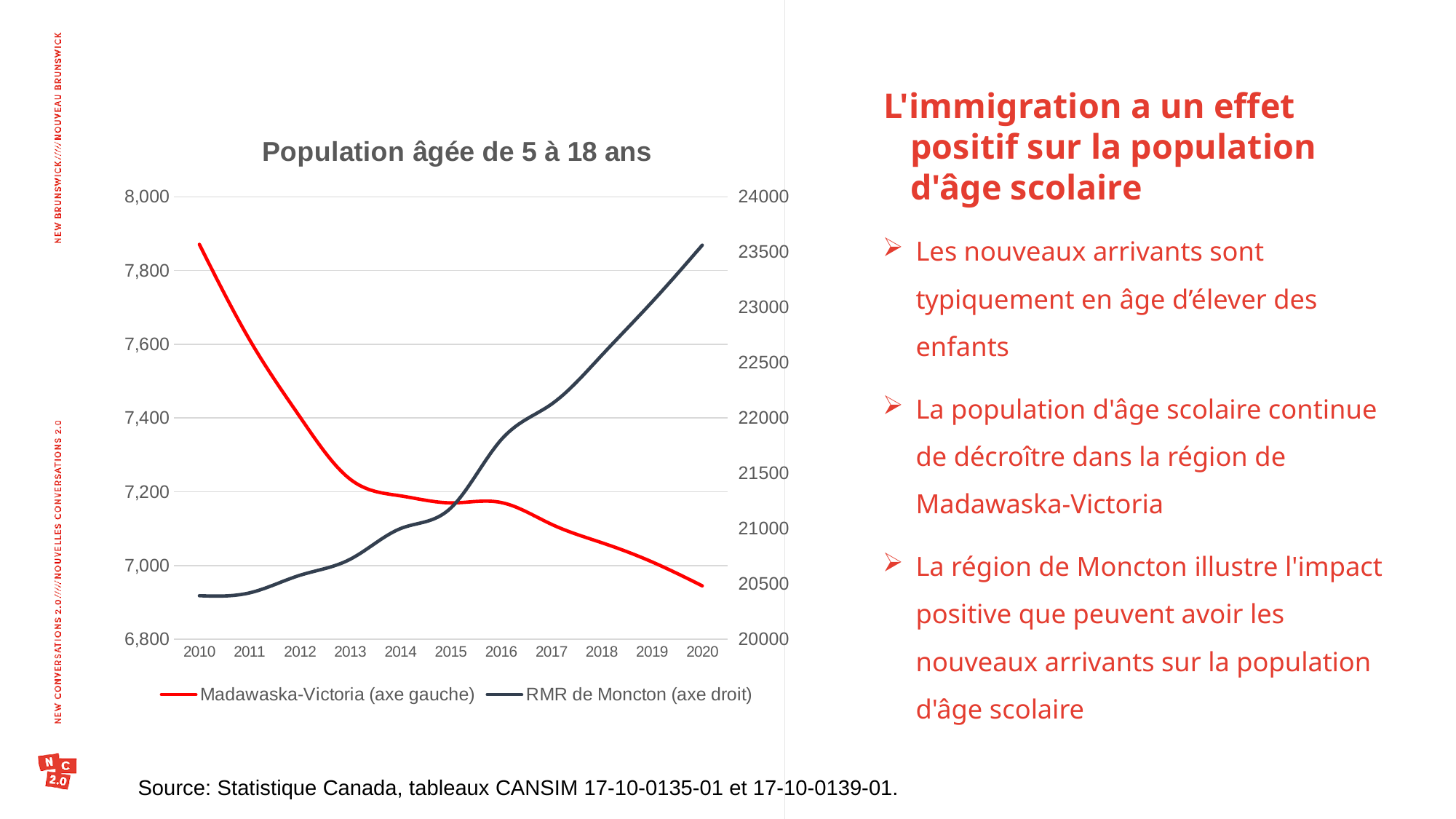
Which colour is used for the RMR de Moncton line? dark grey What kind of chart is shown on the slide? line chart In which year is the Madawaska-Victoria value highest? 2010 Does the Madawaska-Victoria line rise or fall from 2010 to 2020? fall Does the RMR de Moncton line rise or fall from 2010 to 2020? rise How many years are plotted along the x axis? 11 What is the title of the chart? Population âgée de 5 à 18 ans Is the Madawaska-Victoria value for 2020 greater or less than 7,000? less Is the Madawaska-Victoria value for 2010 greater or less than 7,800? greater In which year is the RMR de Moncton value lowest? 2010 How many series does the chart's legend list? 2